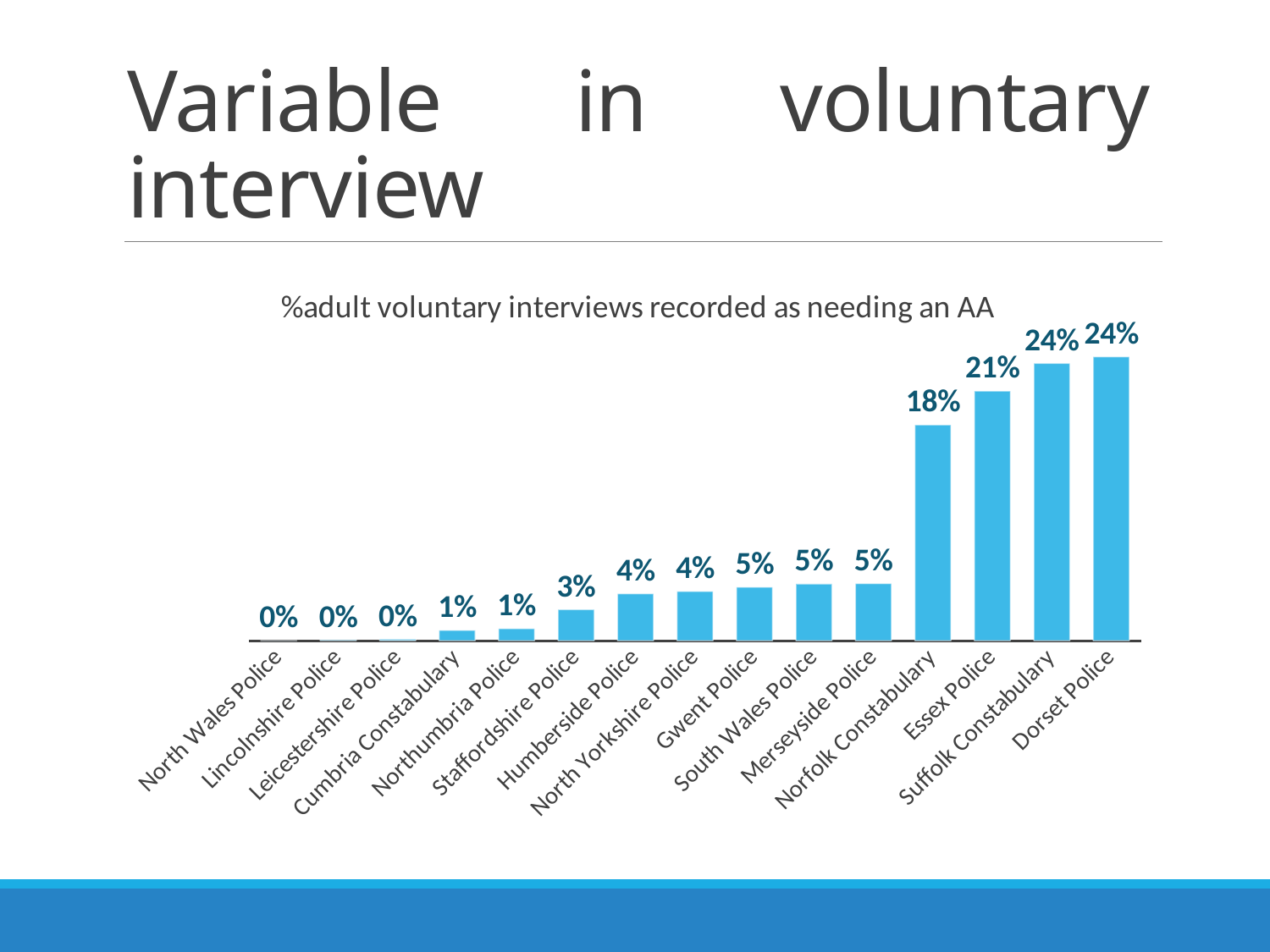
What is the title of the chart? %adult voluntary interviews recorded as needing an AA What is the value for Essex Police? 21% How many police forces are shown on the chart? 15 Which is larger, the value for Essex Police or the value for Merseyside Police? Essex Police What is the highest value shown on the chart? 24% What kind of chart is shown on the slide? Bar chart What is the value for Gwent Police? 5% What is the value for Staffordshire Police? 3% What is the difference between the values for Dorset Police and Norfolk Constabulary? 6% What is the value for Norfolk Constabulary? 18% What is the lowest value shown on the chart? 0% Do the values rise or fall from left to right across the chart? Rise